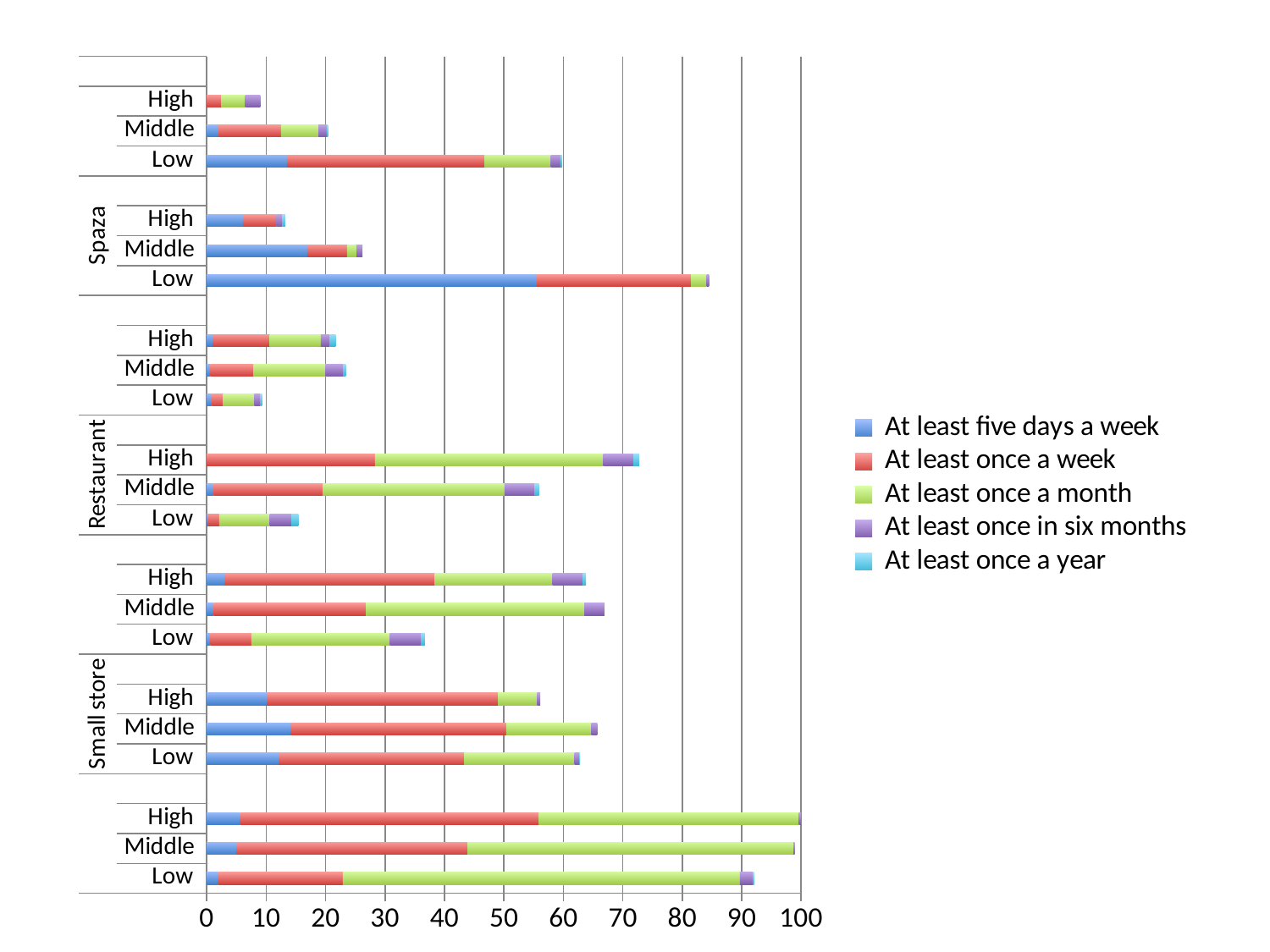
In the second group from the top, which bar is longest: Low, Middle or High? Low Which legend entry is shown in green? At least once a month Which legend entry is shown in blue? At least five days a week What is the highest value shown on the horizontal axis? 100 Is the 'At least five days a week' segment of the 'Low' bar in the second group from the top greater or less than 50? greater In the bottom group of bars, which is longer in total: the 'High' bar or the 'Low' bar? High Is the total length of the 'High' bar in the topmost group of bars greater or less than 10? less Is the total length of the 'Low' bar in the second group from the top greater or less than 80? greater What kind of chart is shown on the slide? bar chart How many bars are plotted in the chart? 21 How many series does the legend list? 5